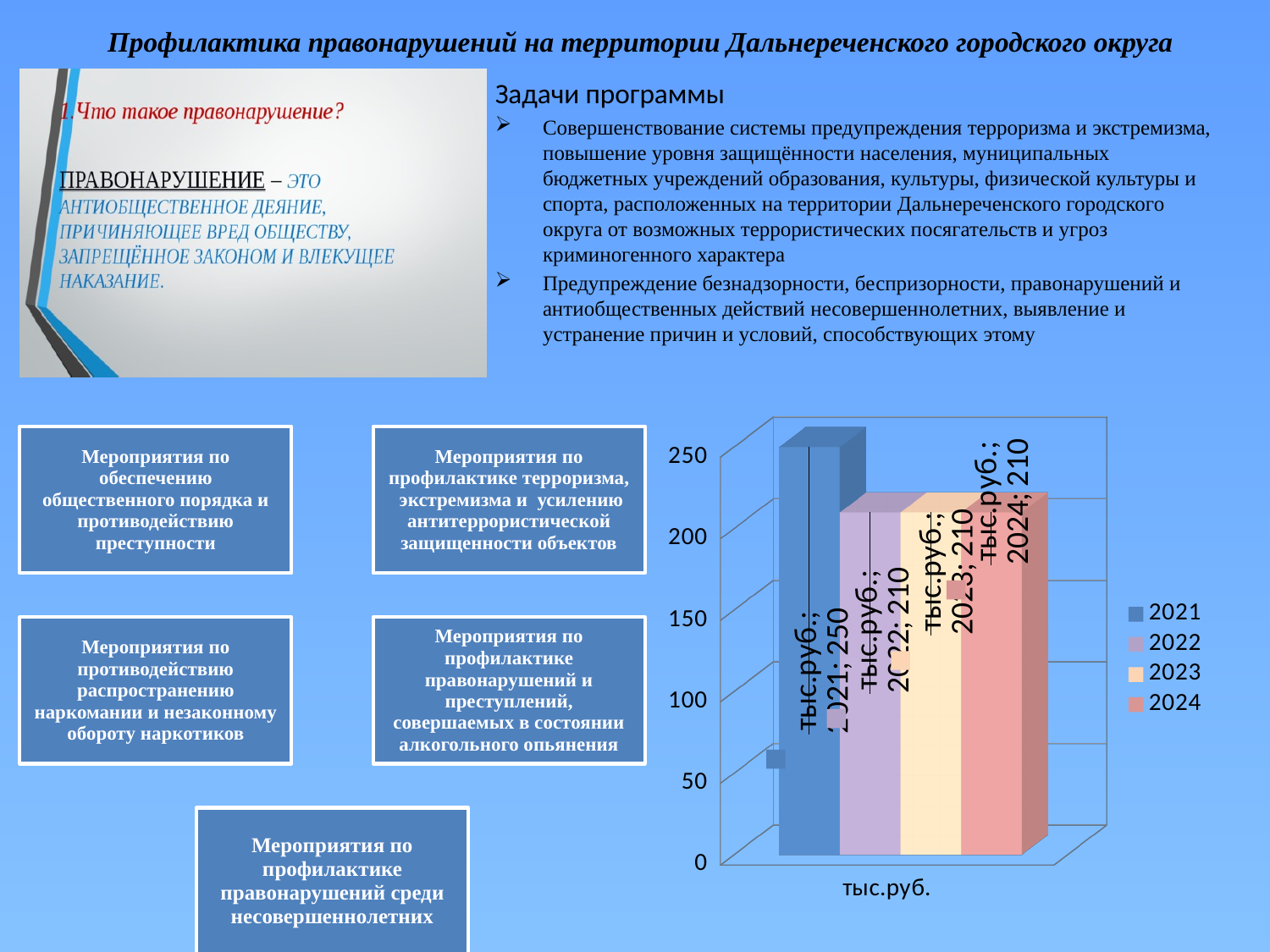
Which year has the highest value in the chart? 2021 What is the category label shown on the x axis of the chart? тыс.руб. What kind of chart is shown on the slide? bar chart Which is larger, the value for 2021 or the value for 2024? 2021 What is the highest value shown on the chart's vertical axis? 250 What is the value for 2023 in the chart? 210 What is the difference between the values for 2021 and 2022? 40 What is the value for 2024 in the chart? 210 What is the value for 2022 in the chart? 210 Is the value for 2023 greater or less than 200? greater How many series does the legend list? 4 What is the value for 2021 in the chart? 250